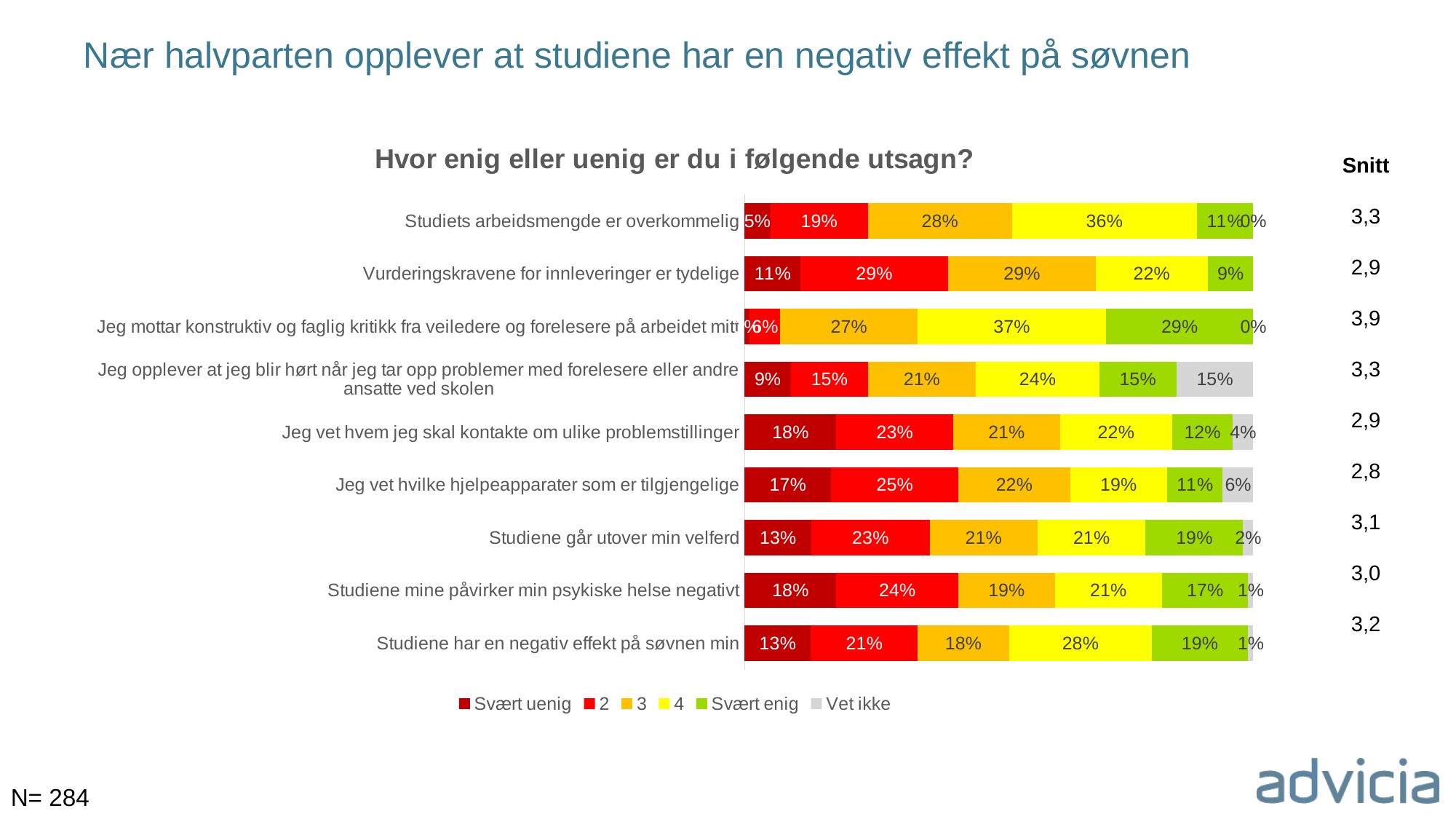
How many statements (categories) are plotted in the chart? 9 Which statement has the lowest 'Svært enig' share? Vurderingskravene for innleveringer er tydelige Which statement has the highest 'Svært enig' share? Jeg mottar konstruktiv og faglig kritikk fra veiledere og forelesere på arbeidet mitt Which statement has the highest share for rating '2'? Vurderingskravene for innleveringer er tydelige Which has the larger 'Svært uenig' share: 'Jeg vet hvilke hjelpeapparater som er tilgjengelige' or 'Studiene går utover min velferd'? Jeg vet hvilke hjelpeapparater som er tilgjengelige What is the 'Svært enig' value for 'Studiene har en negativ effekt på søvnen min'? 19% What is the 'Svært enig' value for 'Vurderingskravene for innleveringer er tydelige'? 9% How many series does the legend list? 6 What is the value for rating '4' for 'Studiets arbeidsmengde er overkommelig'? 36% What is the 'Vet ikke' value for 'Jeg opplever at jeg blir hørt når jeg tar opp problemer med forelesere eller andre ansatte ved skolen'? 15% What kind of chart is shown on the slide? Stacked bar chart For 'Studiene har en negativ effekt på søvnen min', how much larger is the share for rating '4' than for rating '3'? 10 percentage points